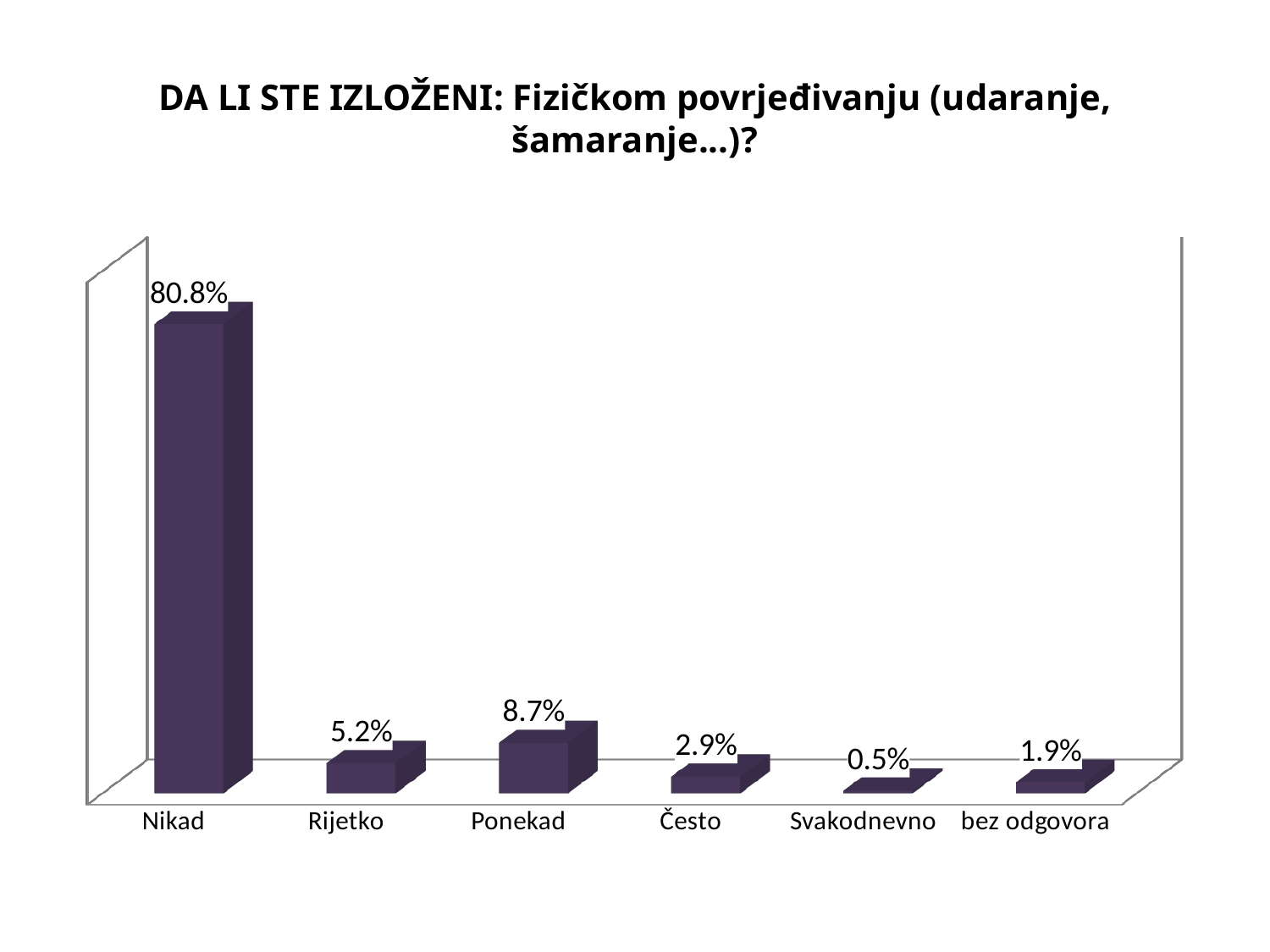
Which category has the lowest value? Svakodnevno What is the value for Svakodnevno? 0.5% How many categories are shown on the x axis? 6 What is the difference between the values for Ponekad and Rijetko? 3.5% What is the value for Ponekad? 8.7% What is the difference between the values for Često and Svakodnevno? 2.4% What kind of chart is shown on the slide? Bar chart Which is larger, the value for Rijetko or the value for Često? Rijetko Which category has the highest value? Nikad What is the value for Nikad? 80.8% What is the title of the chart? DA LI STE IZLOŽENI: Fizičkom povrjeđivanju (udaranje, šamaranje...)? What is the value for bez odgovora? 1.9%